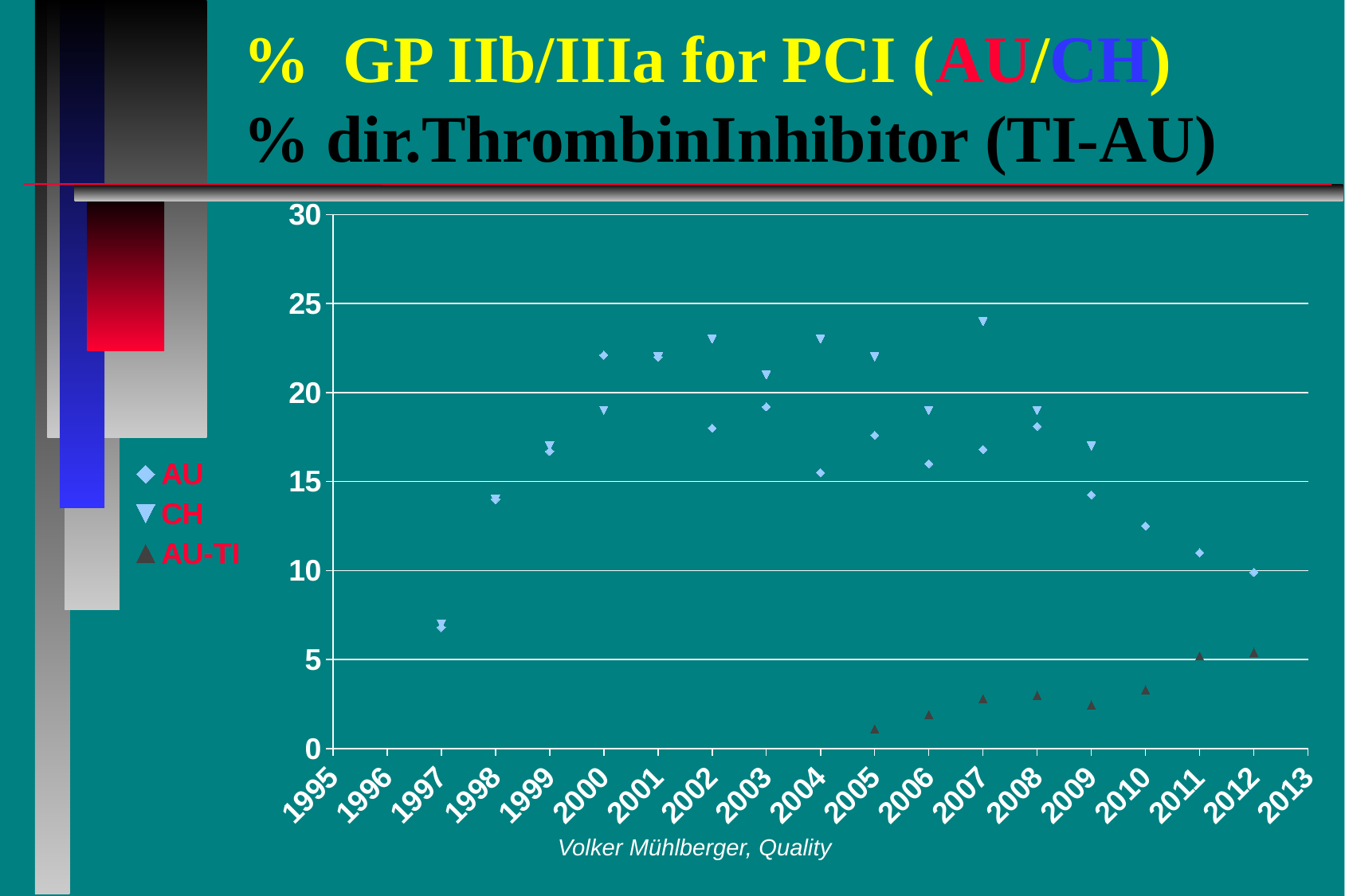
Is the value for AU in 2010 greater or less than 10? greater Do the AU values rise or fall from 2008 to 2012? fall What are the three series named in the legend? AU, CH, AU-TI Is the value for CH in 2007 greater or less than 20? greater Is the value for AU-TI in 2005 greater or less than 5? less What kind of chart is shown on the slide? scatter chart How many series does the legend list? 3 Which marker shape represents the AU-TI series in the legend? triangle In 2007, which series has the larger value, AU or CH? CH In 2000, which series has the larger value, AU or CH? AU